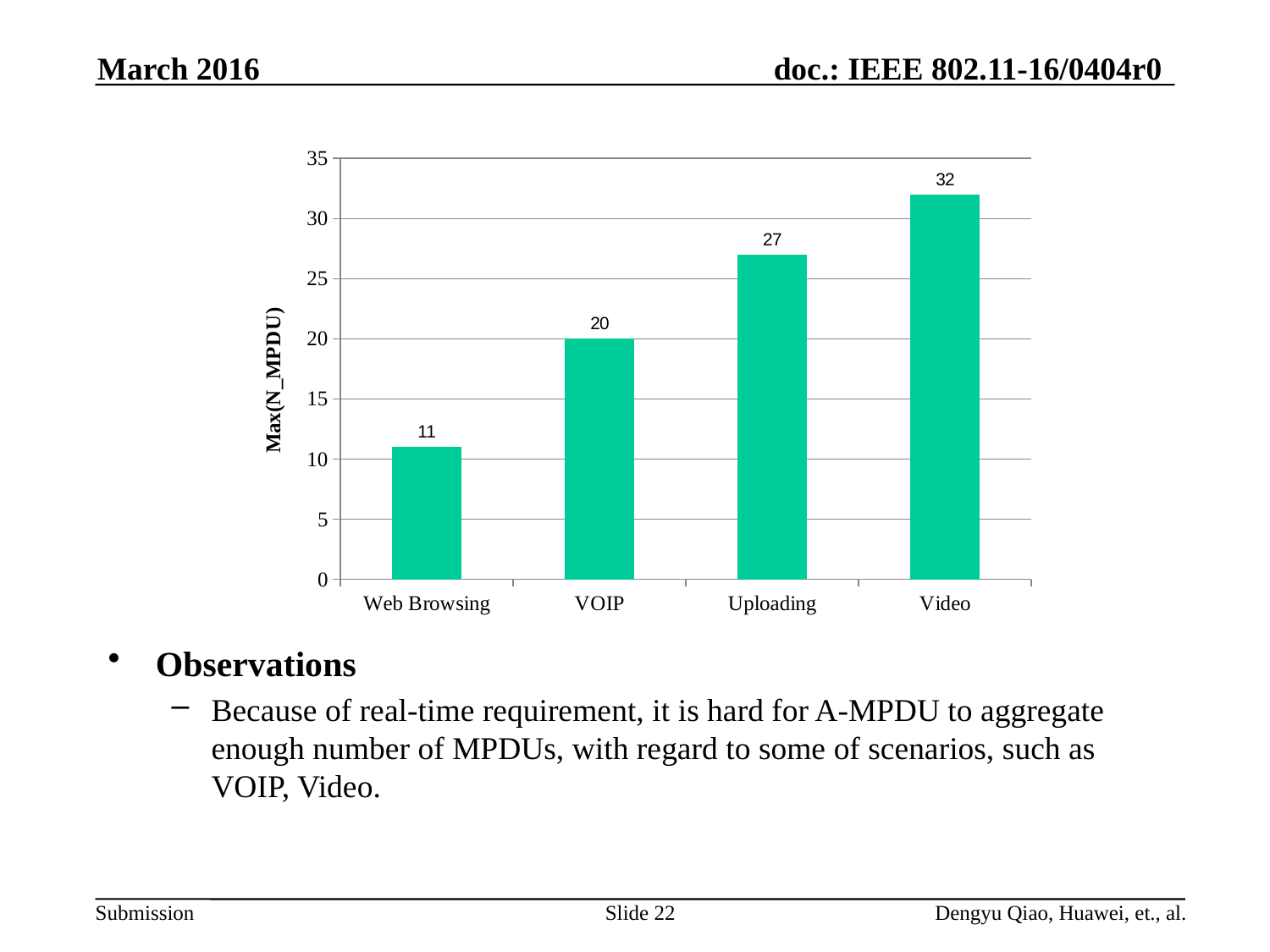
What is the Max(N_MPDU) value for Video? 32 Do the values rise or fall from Web Browsing to Video along the x axis? Rise What kind of chart is shown on the slide? Bar chart Which category has the lowest Max(N_MPDU) value? Web Browsing Which has a larger Max(N_MPDU) value, VOIP or Uploading? Uploading What is the difference between the Max(N_MPDU) values for Video and Web Browsing? 21 What is the Max(N_MPDU) value for VOIP? 20 What is the difference between the Max(N_MPDU) values for Uploading and VOIP? 7 Which category has the highest Max(N_MPDU) value? Video How many categories are shown on the x axis of the chart? 4 What is the Max(N_MPDU) value for Web Browsing? 11 What is the Max(N_MPDU) value for Uploading? 27